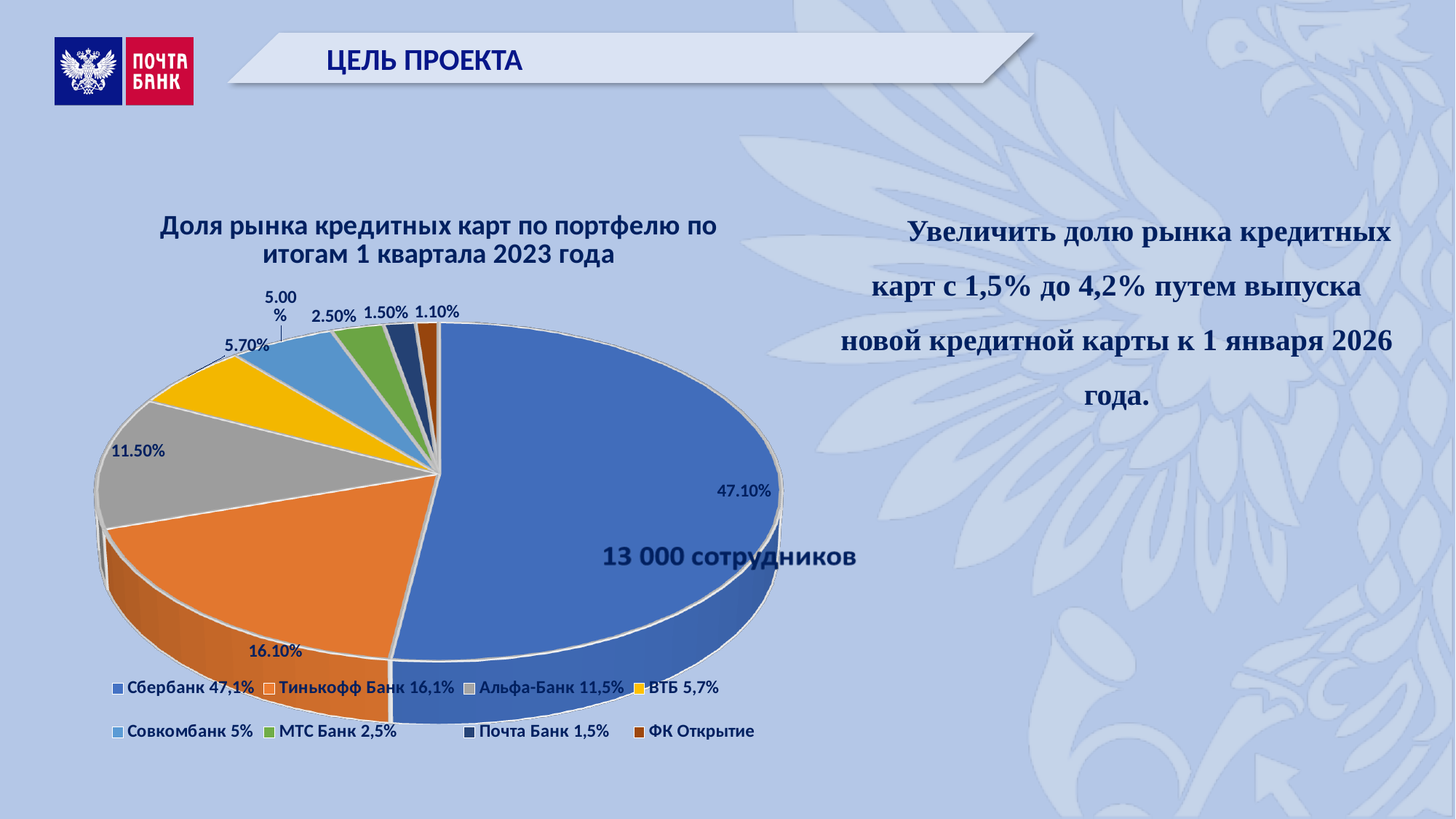
Which has a larger share, ВТБ or Совкомбанк? ВТБ What is the share shown for ФК Открытие in the pie chart? 1.10% What is the share shown for Почта Банк in the pie chart? 1.50% What kind of chart is shown on the slide? pie chart What is the share shown for Альфа-Банк in the pie chart? 11.50% Which bank has the largest slice in the pie chart? Сбербанк What is the difference between the shares of Сбербанк and Тинькофф Банк? 31.00% What is the share shown for Тинькофф Банк in the pie chart? 16.10% What is the share shown for Сбербанк in the pie chart? 47.10% How many slices (banks) does the pie chart show? 8 What is the title of the pie chart? Доля рынка кредитных карт по портфелю по итогам 1 квартала 2023 года Which bank has the smallest slice in the pie chart? ФК Открытие